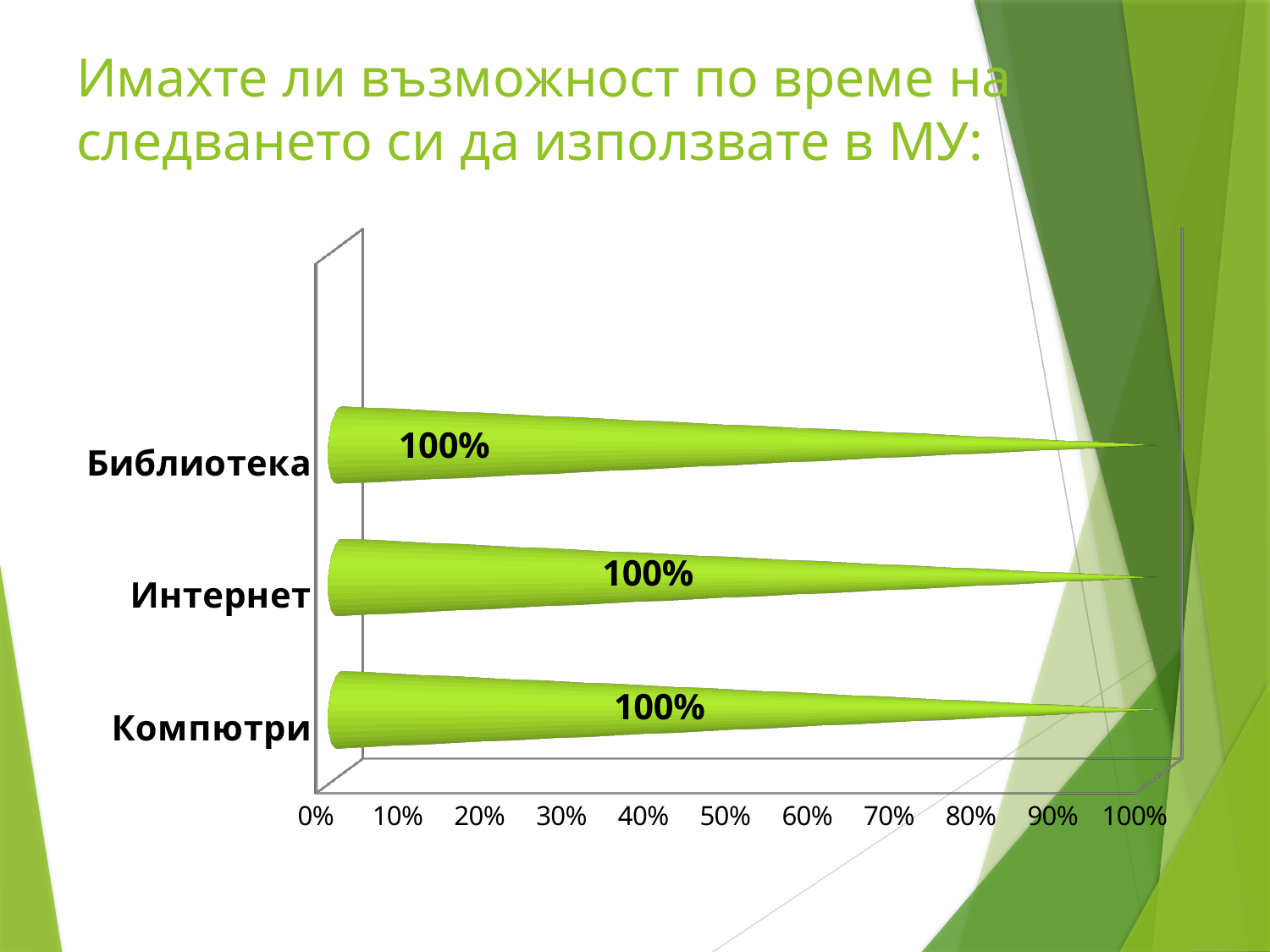
What is the difference between the values for Интернет and Библиотека? 0% What is the highest tick label shown on the horizontal axis? 100% What is the value for Библиотека? 100% How many categories are shown in the chart? 3 Is the value for Компютри greater or less than 50%? greater What is the value for Компютри? 100% What is the value for Интернет? 100% What kind of chart is shown on the slide? bar chart Is the value for Библиотека greater or less than 90%? greater What is the title of the slide above the chart? Имахте ли възможност по време на следването си да използвате в МУ: What is the difference between the values for Компютри and Интернет? 0%